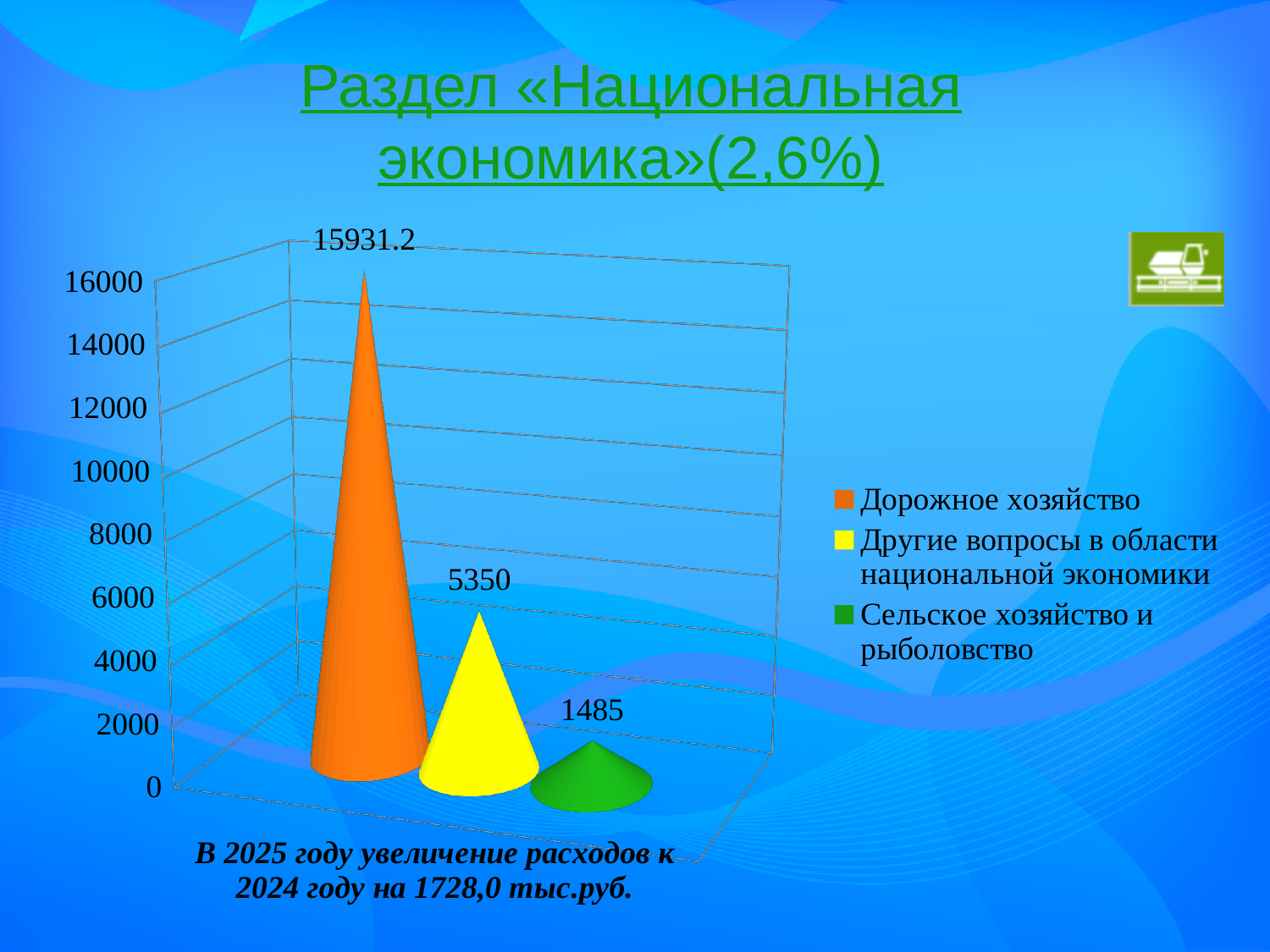
What colour represents Сельское хозяйство и рыболовство in the chart? green What is the value for Сельское хозяйство и рыболовство? 1485 Which series has the highest value? Дорожное хозяйство What kind of chart is shown on the slide? bar chart What is the value for Дорожное хозяйство? 15931.2 Is the value for Другие вопросы в области национальной экономики greater or less than 4000? greater What is the difference between the values for Другие вопросы в области национальной экономики and Сельское хозяйство и рыболовство? 3865 Which series has the lowest value? Сельское хозяйство и рыболовство Is the value for Сельское хозяйство и рыболовство greater or less than 2000? less How many series does the legend list? 3 What is the value for Другие вопросы в области национальной экономики? 5350 Which is larger: the value for Дорожное хозяйство or the value for Другие вопросы в области национальной экономики? Дорожное хозяйство